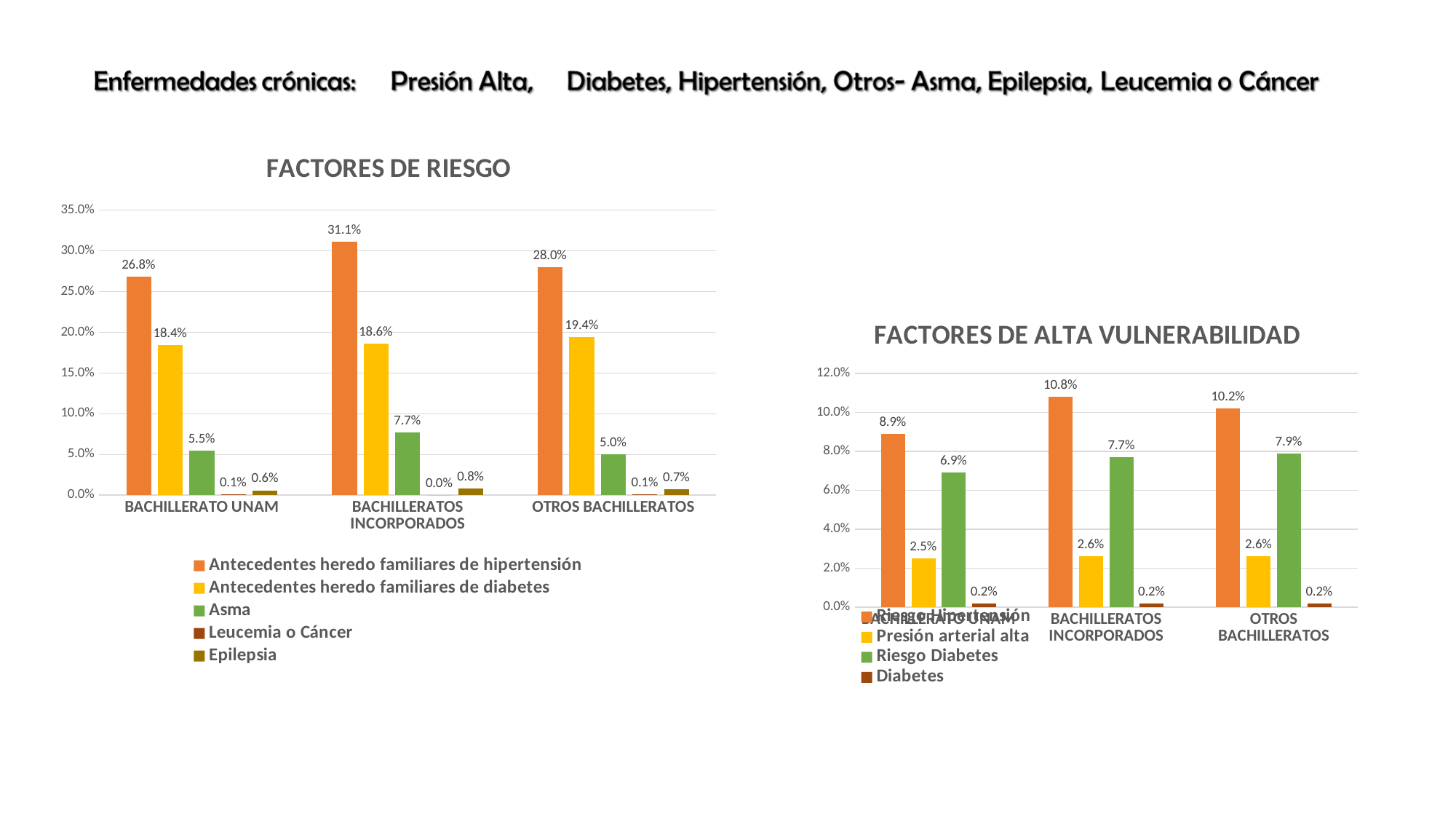
In the FACTORES DE RIESGO chart, how many series does the legend list? 5 In the FACTORES DE ALTA VULNERABILIDAD chart, is Riesgo Hipertensión for OTROS BACHILLERATOS greater or less than 10.0%? greater In the FACTORES DE ALTA VULNERABILIDAD chart, what is the difference between Riesgo Hipertensión and Riesgo Diabetes for BACHILLERATOS INCORPORADOS? 3.1% In the FACTORES DE ALTA VULNERABILIDAD chart, how many categories are shown on the x axis? 3 In the FACTORES DE RIESGO chart, what is the difference between Antecedentes heredo familiares de hipertensión and Antecedentes heredo familiares de diabetes for BACHILLERATO UNAM? 8.4% In the FACTORES DE ALTA VULNERABILIDAD chart, what is the value of Riesgo Diabetes for OTROS BACHILLERATOS? 7.9% In the FACTORES DE RIESGO chart, which category has the highest value for Antecedentes heredo familiares de hipertensión? BACHILLERATOS INCORPORADOS In the FACTORES DE RIESGO chart, what is the value of Antecedentes heredo familiares de hipertensión for BACHILLERATOS INCORPORADOS? 31.1% In the FACTORES DE RIESGO chart, which category has the lowest value for Asma? OTROS BACHILLERATOS In the FACTORES DE RIESGO chart, what is the value of Asma for OTROS BACHILLERATOS? 5.0% In the FACTORES DE ALTA VULNERABILIDAD chart, which category has the highest value for Riesgo Hipertensión? BACHILLERATOS INCORPORADOS What type of chart is the FACTORES DE ALTA VULNERABILIDAD chart? Bar chart